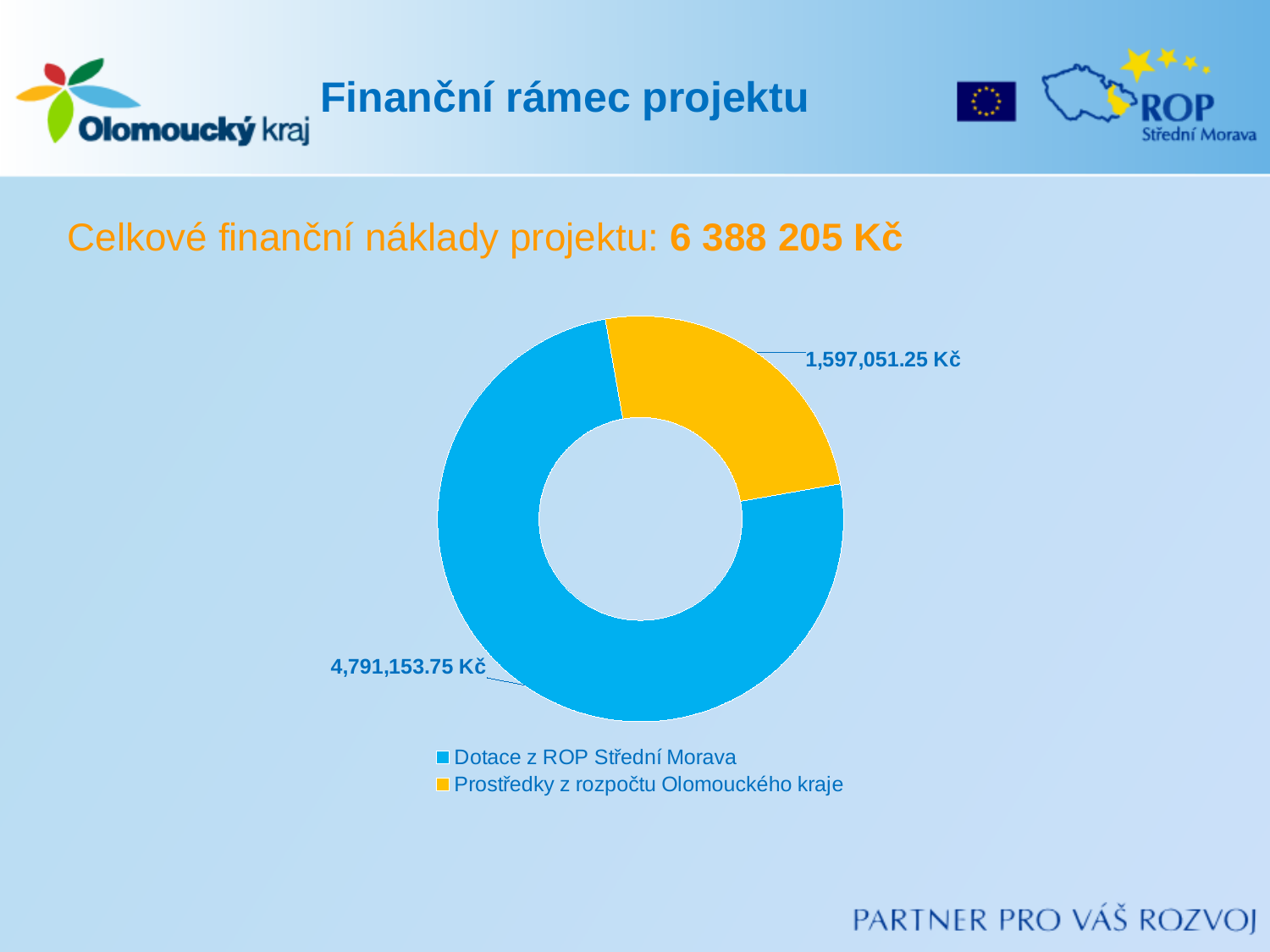
Which category has the largest slice? Dotace z ROP Střední Morava What share of the total does Dotace z ROP Střední Morava represent? 75% How many entries does the legend list? 2 What is the difference between the value for Dotace z ROP Střední Morava and the value for Prostředky z rozpočtu Olomouckého kraje? 3,194,102.50 Kč Which is larger: Dotace z ROP Střední Morava or Prostředky z rozpočtu Olomouckého kraje? Dotace z ROP Střední Morava How many slices does the chart have? 2 Which category has the smallest slice? Prostředky z rozpočtu Olomouckého kraje What is the value for Prostředky z rozpočtu Olomouckého kraje? 1,597,051.25 Kč What colour is the slice for Prostředky z rozpočtu Olomouckého kraje? Yellow What kind of chart is shown on the slide? Doughnut chart What is the total of the two slices? 6,388,205 Kč What is the value for Dotace z ROP Střední Morava? 4,791,153.75 Kč